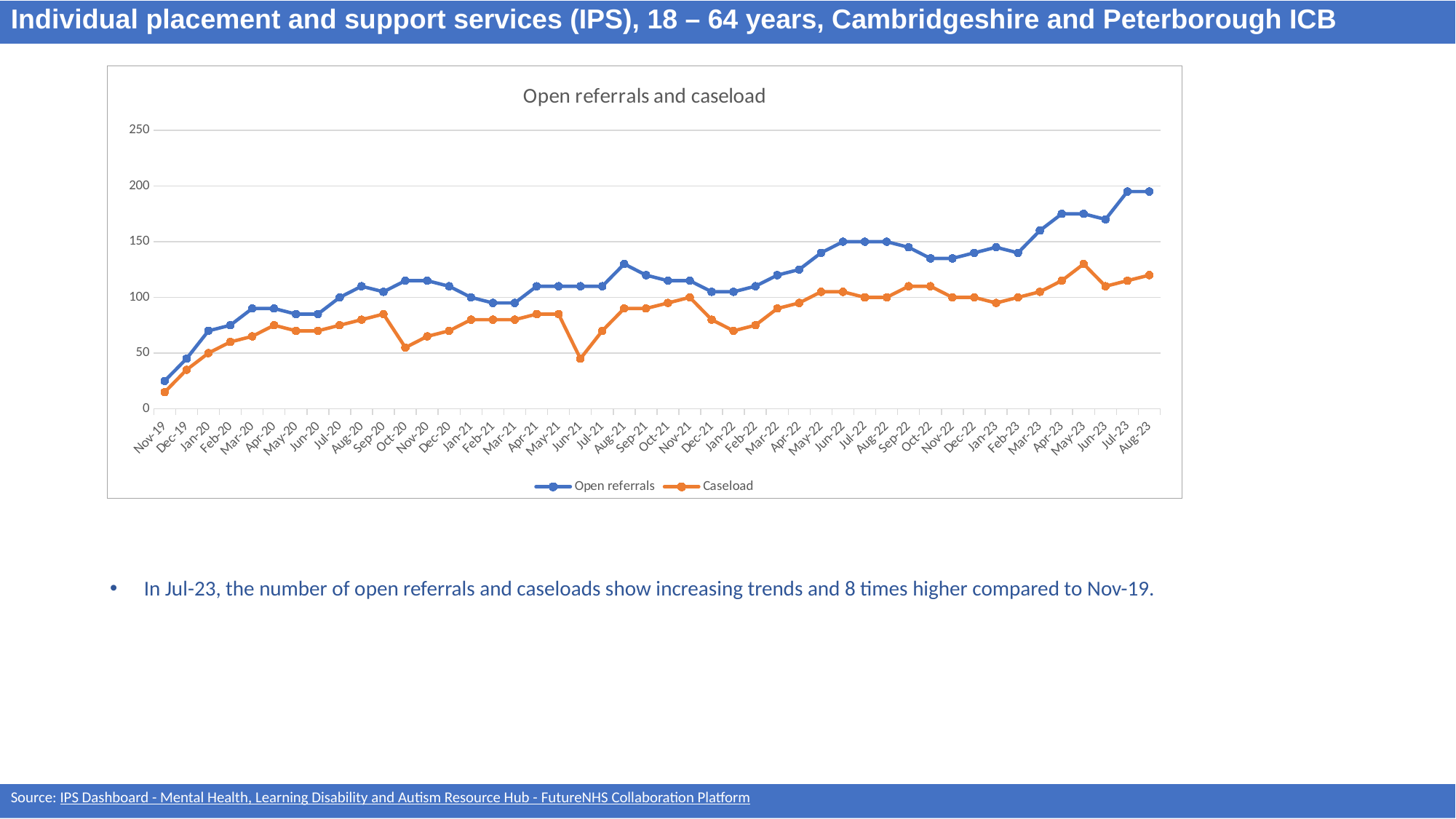
In which month is the Open referrals series at its lowest? Nov-19 How many months are shown on the x axis? 46 Which series is drawn in orange? Caseload Is the value for Caseload in May-23 greater or less than 100? greater Is the value for Open referrals in Aug-23 greater or less than 150? greater Is the value for Caseload in Jun-21 greater or less than 50? less What is the title of the chart? Open referrals and caseload In Aug-23, which is larger: Open referrals or Caseload? Open referrals In which month is the Caseload series at its highest? May-23 What kind of chart is shown on the slide? Line chart How many series does the legend list? 2